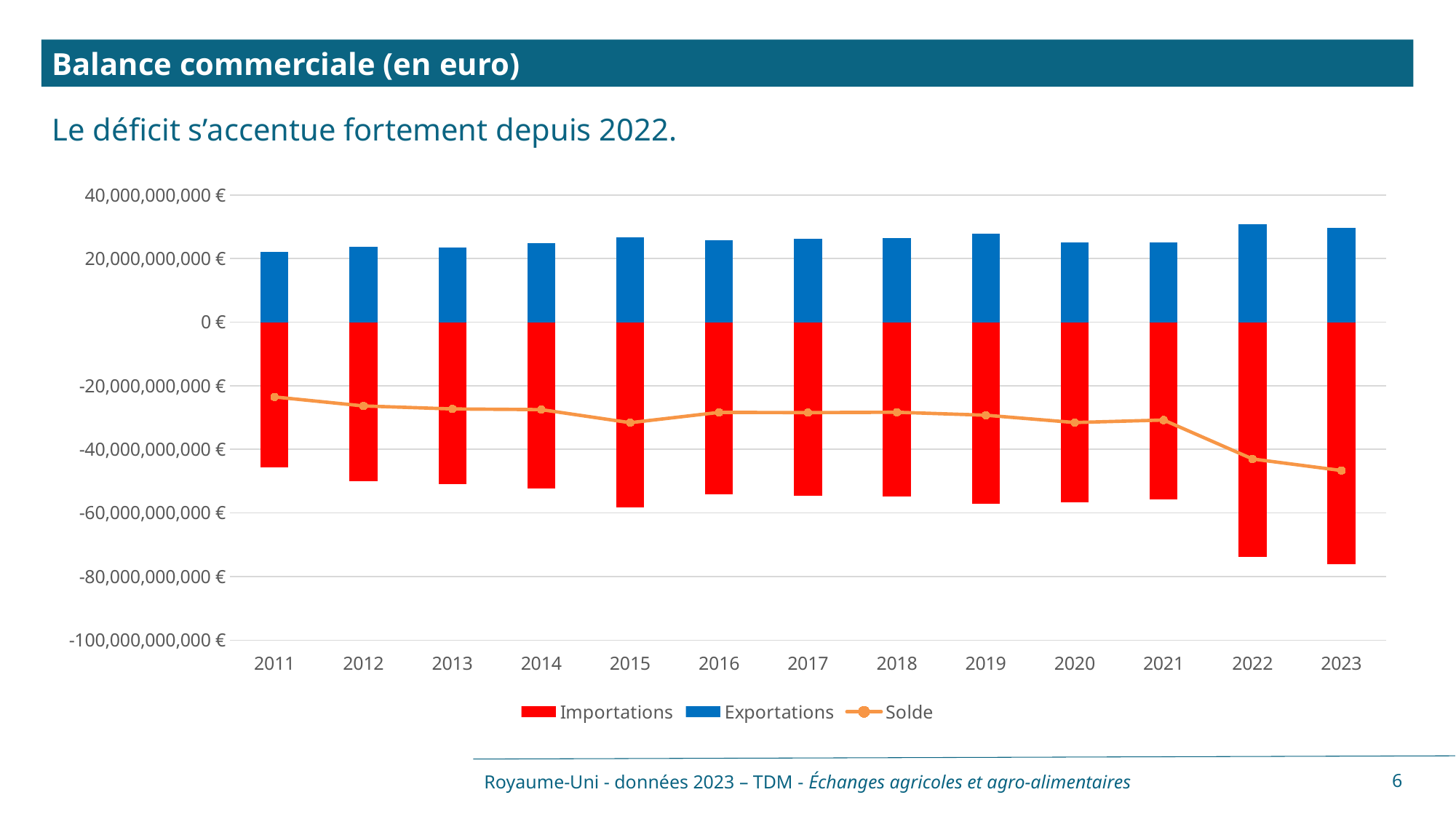
What colour are the Importations bars? Red Is the Solde value for 2023 greater or less than -40,000,000,000 €? less Which year has the smallest Importations bar (closest to zero)? 2011 What kind of chart is this? Bar chart with a line series Which year has the lowest Exportations bar? 2011 Is the Solde value for 2011 greater or less than -40,000,000,000 €? greater How many series does the legend list? 3 Is the Importations value for 2022 greater or less than -60,000,000,000 €? less Does the Solde line rise or fall overall from 2011 to 2023? Falls Which is larger, the Exportations value for 2022 or for 2011? 2022 How many years are shown on the x axis? 13